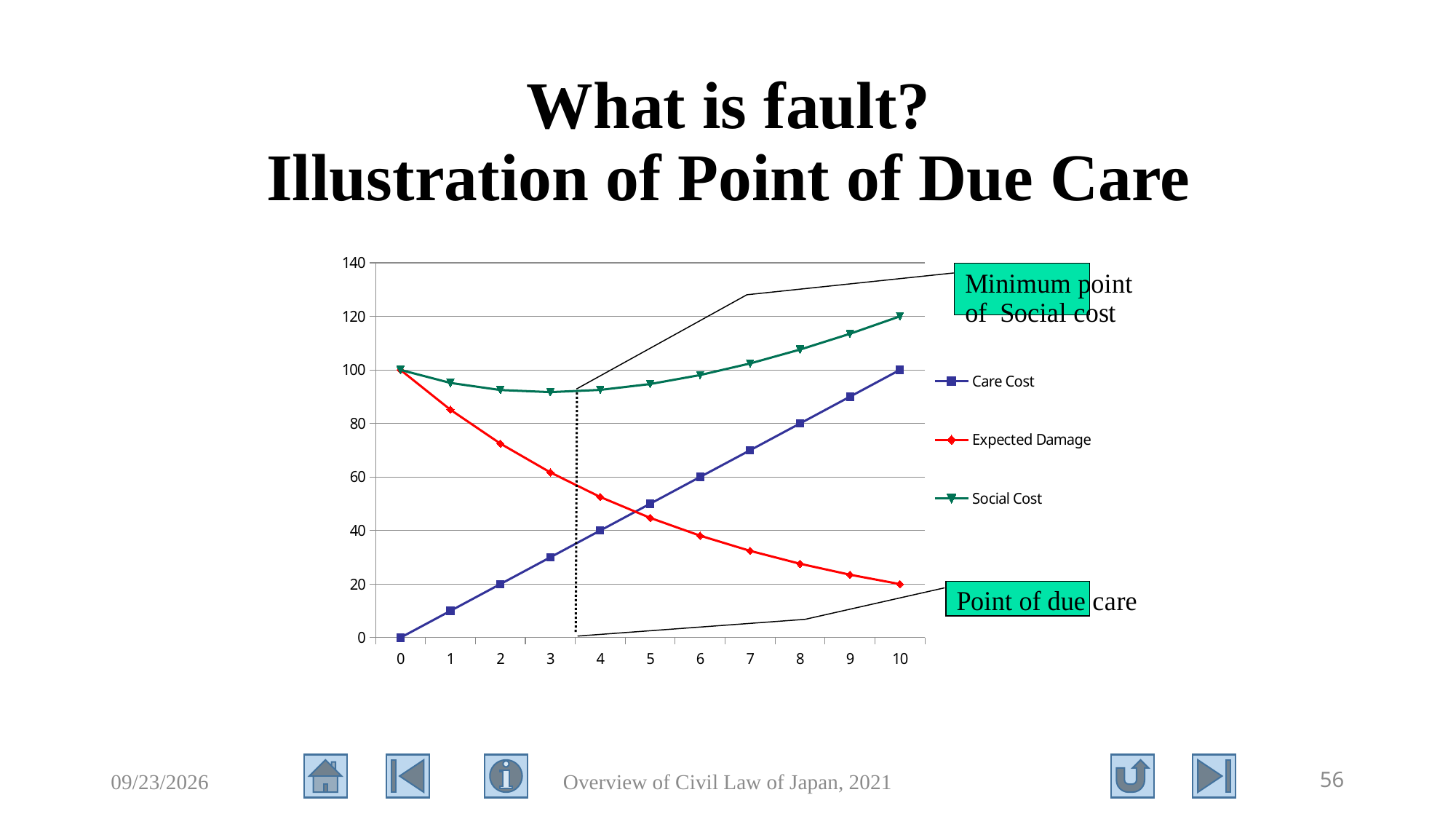
Is the value of Social Cost at x = 3 greater or less than 100? less What is the value of Expected Damage at x = 0? 100 What is the value of Expected Damage at x = 10? 20 Does Expected Damage rise or fall as x increases from 0 to 10? fall What is the value of Social Cost at x = 10? 120 What kind of chart is shown on the slide? line chart Which series has the highest value at x = 10? Social Cost What is the value of Care Cost at x = 10? 100 Does Care Cost rise or fall as x increases from 0 to 10? rise How many points are marked along the x axis? 11 How many series does the legend list? 3 What is the difference between Social Cost and Care Cost at x = 10? 20